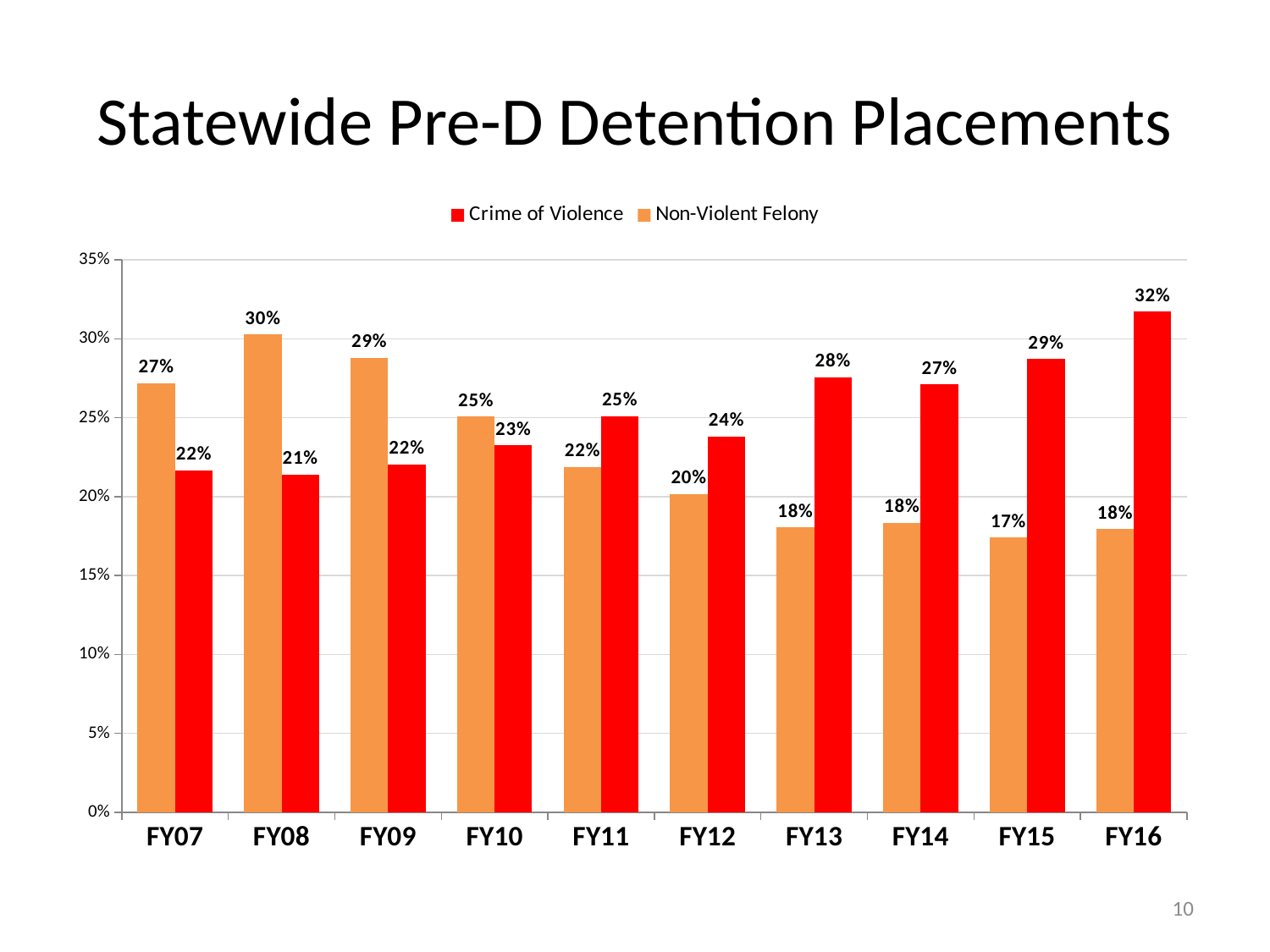
In which fiscal year is the Non-Violent Felony value lowest? FY15 In which fiscal year is the Crime of Violence value highest? FY16 What is the Non-Violent Felony value for FY08? 30% What is the difference between the Crime of Violence and Non-Violent Felony values in FY16? 14% What type of chart is shown on the slide? Bar chart What is the Crime of Violence value for FY16? 32% In FY07, which is larger: Crime of Violence or Non-Violent Felony? Non-Violent Felony How many series does the legend list? 2 How many fiscal years are shown on the x axis? 10 Does the Crime of Violence series generally rise or fall from FY07 to FY16? Rise What is the Crime of Violence value for FY10? 23% What colour represents the Crime of Violence series? Red